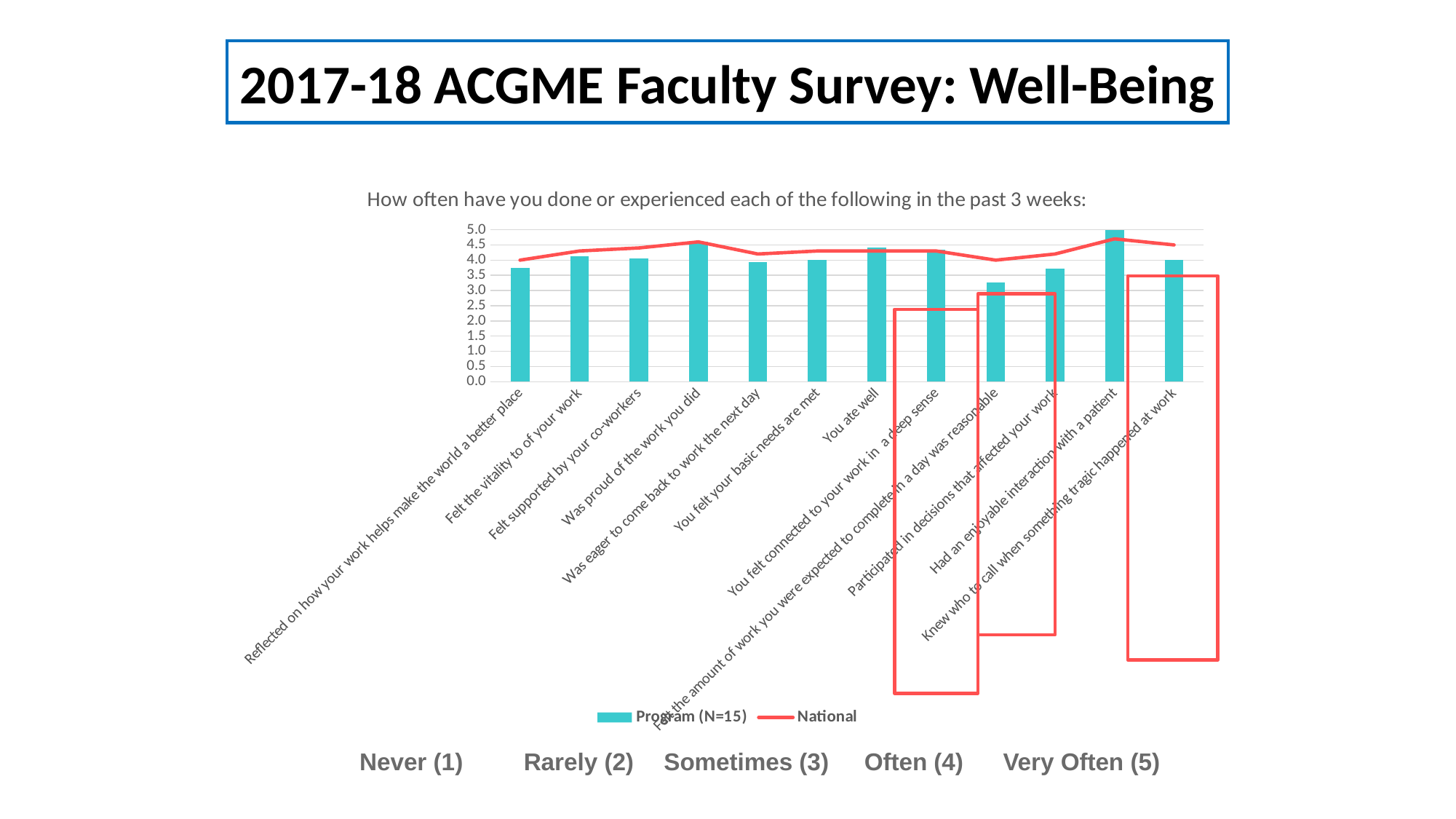
What kind of chart is shown on the slide? Bar chart with a line overlay What is the Program (N=15) value for 'Had an enjoyable interaction with a patient'? 5.0 How many series does the legend list? 2 How many categories are plotted along the x axis? 12 What is the chart's title? How often have you done or experienced each of the following in the past 3 weeks: Is the Program (N=15) value for 'Felt the amount of work you were expected to complete in a day was reasonable' greater or less than 3.5? less Is the Program (N=15) value for 'Reflected on how your work helps make the world a better place' greater or less than 4.0? less Is the Program (N=15) value for 'Participated in decisions that affected your work' greater or less than 4.0? less For 'Had an enjoyable interaction with a patient', which is larger: the Program (N=15) value or the National value? Program (N=15) Which category has the highest Program (N=15) bar? Had an enjoyable interaction with a patient Which category has the lowest Program (N=15) bar? Felt the amount of work you were expected to complete in a day was reasonable What are the two series named in the legend? Program (N=15) and National